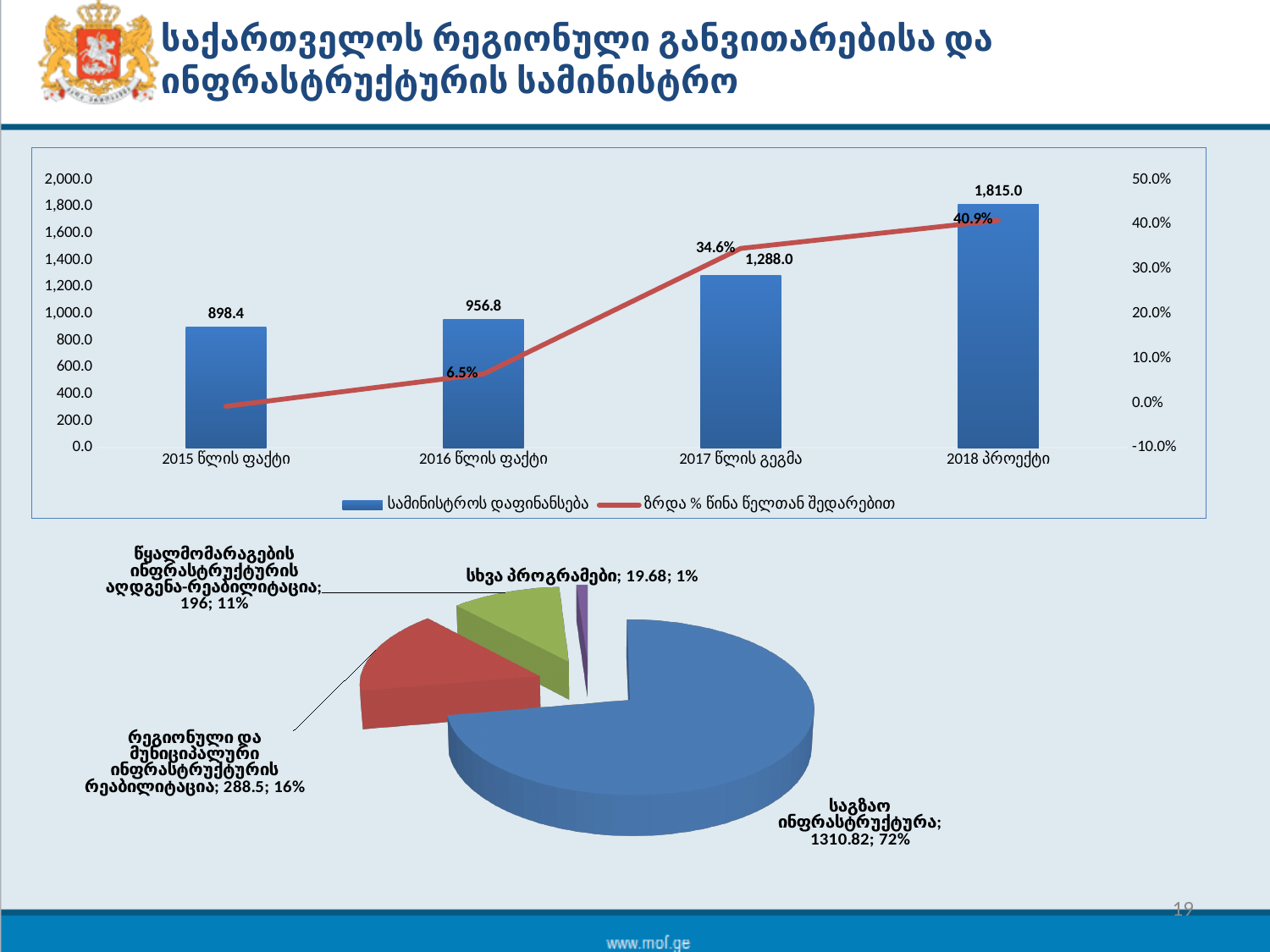
In the top chart, what growth percentage is shown on the line for 2017 წლის გეგმა? 34.6% In the top chart, how many series does the legend list? 2 In the top chart, what is the value of the bar for 2018 პროექტი? 1,815.0 In the bottom pie chart, what is the value for რეგიონული და მუნიციპალური ინფრასტრუქტურის რეაბილიტაცია? 288.5 In the top chart, what is the difference between the bar values for 2018 პროექტი and 2017 წლის გეგმა? 527.0 In the bottom pie chart, what share does საგზაო ინფრასტრუქტურა have? 72% In the top chart, do the bar values rise or fall from 2015 to 2018? rise What kind of chart is the bottom chart on the slide? pie chart In the top chart, what is the value of the bar for 2015 წლის ფაქტი? 898.4 In the top chart, which category has the highest bar? 2018 პროექტი In the bottom pie chart, which slice is the smallest? სხვა პროგრამები In the top chart, how many categories are shown on the x axis? 4